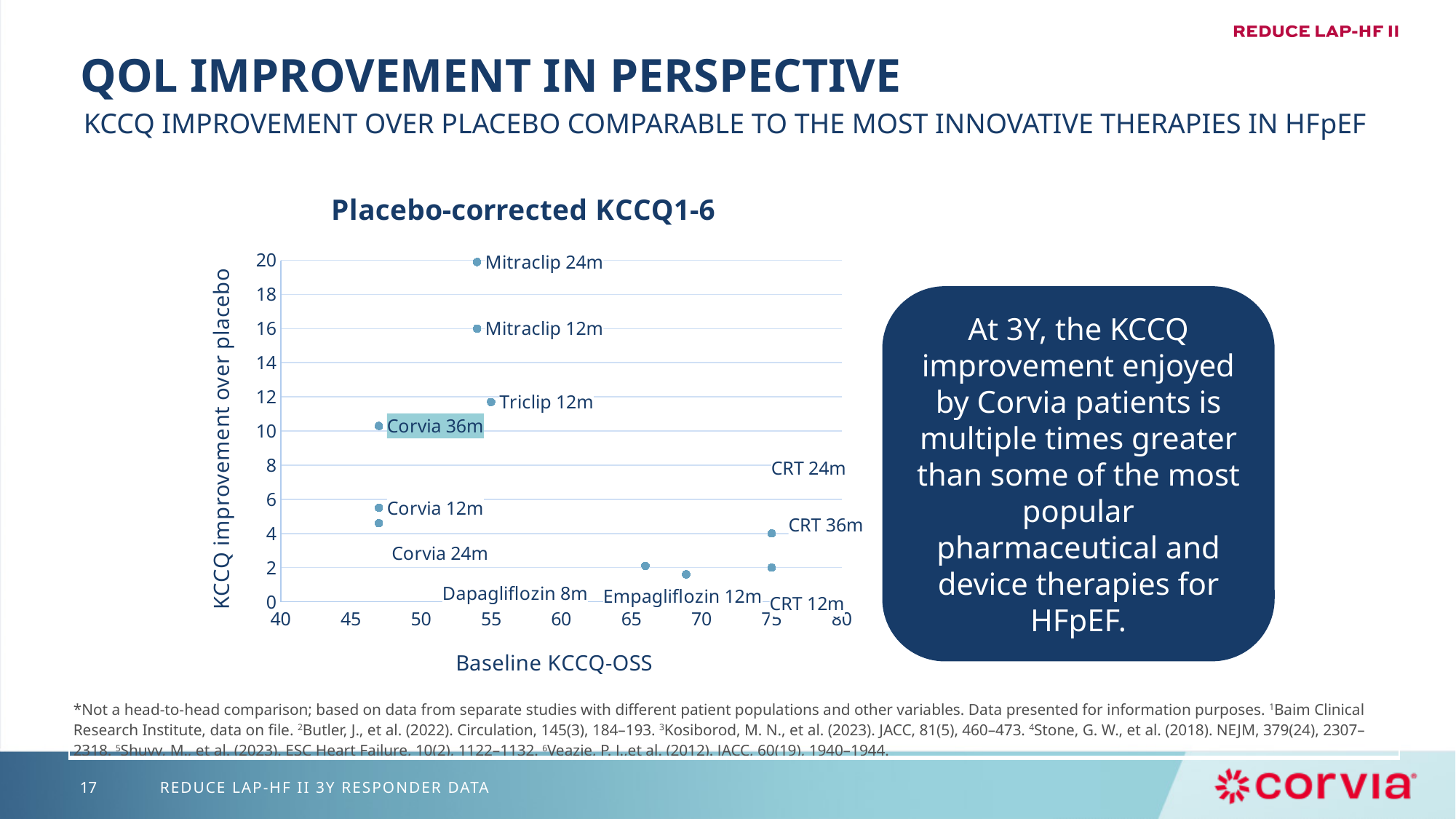
What kind of chart is shown on the slide? Scatter chart Is the KCCQ improvement over placebo for Empagliflozin 12m greater or less than 2? less What is the title of the chart? Placebo-corrected KCCQ1-6 Which has a higher KCCQ improvement over placebo, Corvia 36m or CRT 36m? Corvia 36m Is the KCCQ improvement over placebo for Mitraclip 24m greater or less than 18? greater Is the KCCQ improvement over placebo for Dapagliflozin 8m greater or less than 4? less Which has a higher KCCQ improvement over placebo, Mitraclip 24m or Mitraclip 12m? Mitraclip 24m Which has a higher KCCQ improvement over placebo, Corvia 36m or Corvia 12m? Corvia 36m What is the label of the x axis of the chart? Baseline KCCQ-OSS Which point has the highest KCCQ improvement over placebo? Mitraclip 24m